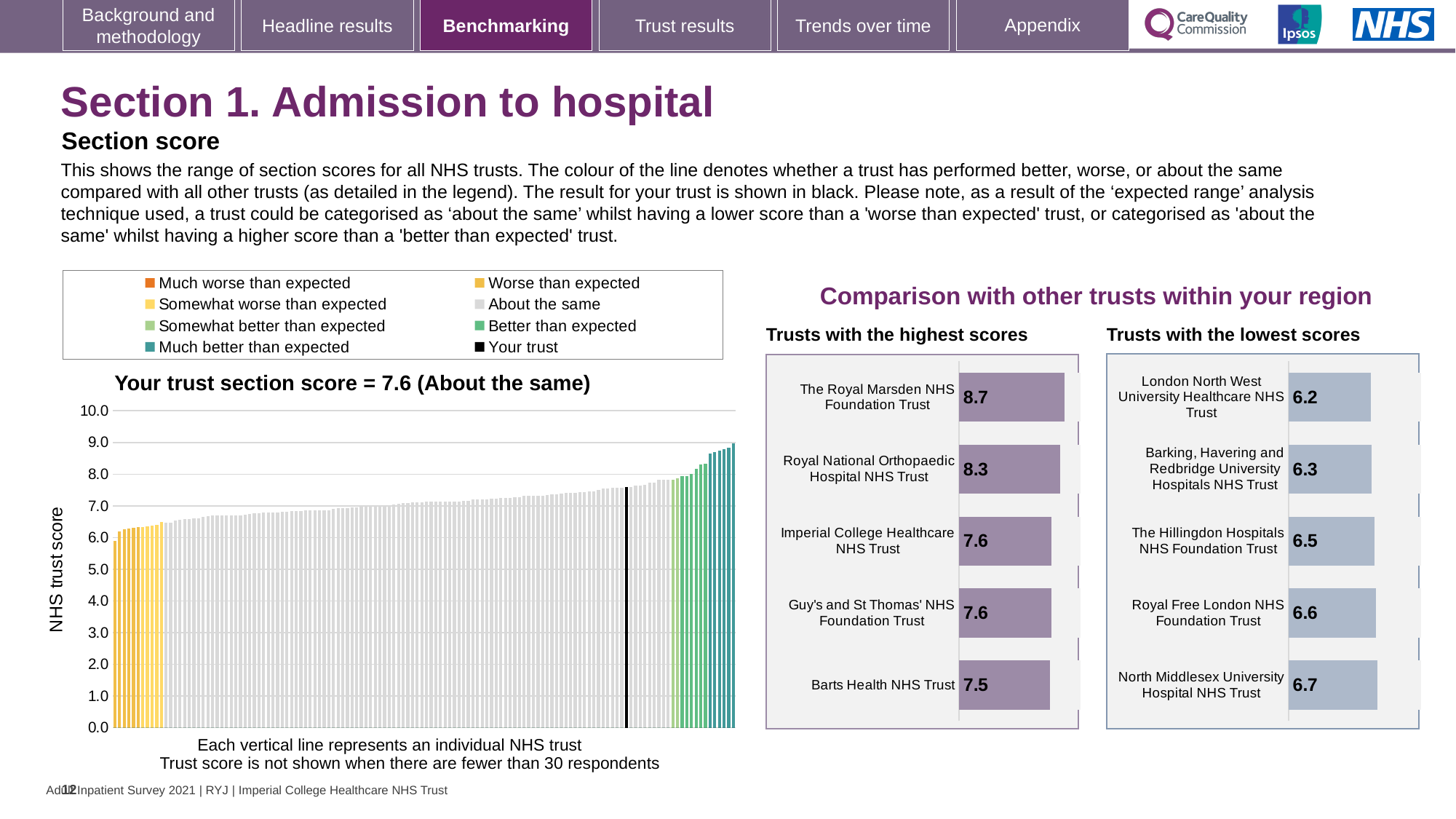
In the 'Trusts with the lowest scores' chart, which has the larger score: Royal Free London NHS Foundation Trust or Barking, Havering and Redbridge University Hospitals NHS Trust? Royal Free London NHS Foundation Trust In the 'Trusts with the highest scores' chart, what is the score for The Royal Marsden NHS Foundation Trust? 8.7 In the 'Trusts with the lowest scores' chart, what is the difference between the scores of North Middlesex University Hospital NHS Trust and London North West University Healthcare NHS Trust? 0.5 In the 'Trusts with the lowest scores' chart, what is the score for The Hillingdon Hospitals NHS Foundation Trust? 6.5 In the 'Trusts with the highest scores' chart, what is the score for Barts Health NHS Trust? 7.5 In the main chart on the left, do the trust scores rise or fall from left to right along the x axis? rise In the 'Trusts with the highest scores' chart, how many trusts are shown? 5 How many entries does the legend above the main chart on the left list? 8 In the 'Trusts with the lowest scores' chart, which trust has the lowest score? London North West University Healthcare NHS Trust In the main chart on the left, what is your trust's section score? 7.6 In the 'Trusts with the highest scores' chart, which trust has the highest score? The Royal Marsden NHS Foundation Trust In the 'Trusts with the highest scores' chart, what is the difference between the scores of The Royal Marsden NHS Foundation Trust and Barts Health NHS Trust? 1.2